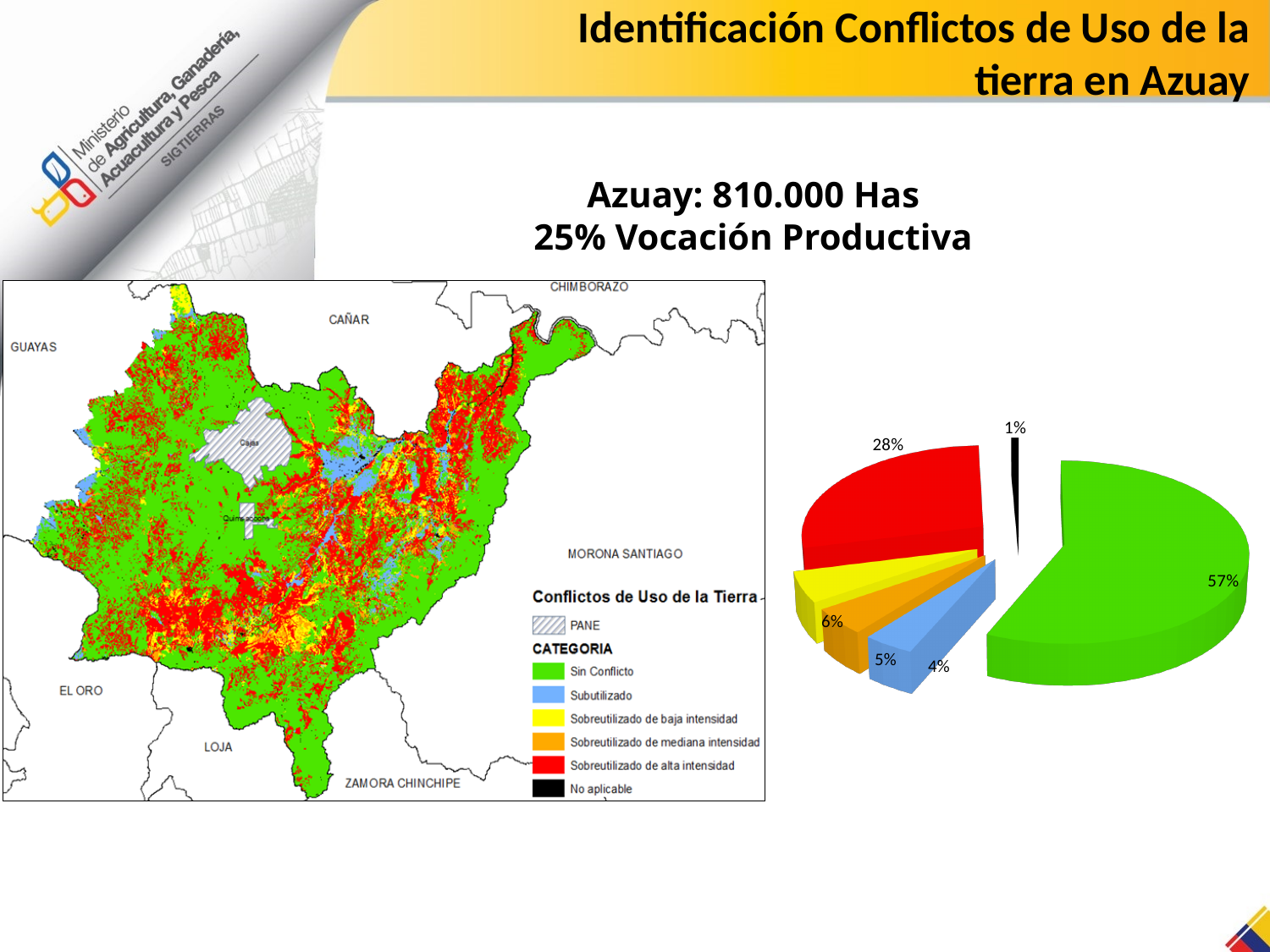
Which slice of the pie chart is the smallest? The black slice (1%) What percentage is shown for the yellow slice of the pie chart? 6% What percentage is shown for the black slice of the pie chart? 1% Which slice of the pie chart is the largest? The green slice (57%) What percentage is shown for the blue slice of the pie chart? 4% What kind of chart is shown on the right side of the slide? Pie chart By how many percentage points does the green slice exceed the red slice in the pie chart? 29 percentage points How many slices does the pie chart have? 6 What percentage is shown for the red slice of the pie chart? 28% What percentage is shown for the green slice of the pie chart? 57% What percentage is shown for the orange slice of the pie chart? 5% Which is larger in the pie chart, the yellow slice or the orange slice? The yellow slice